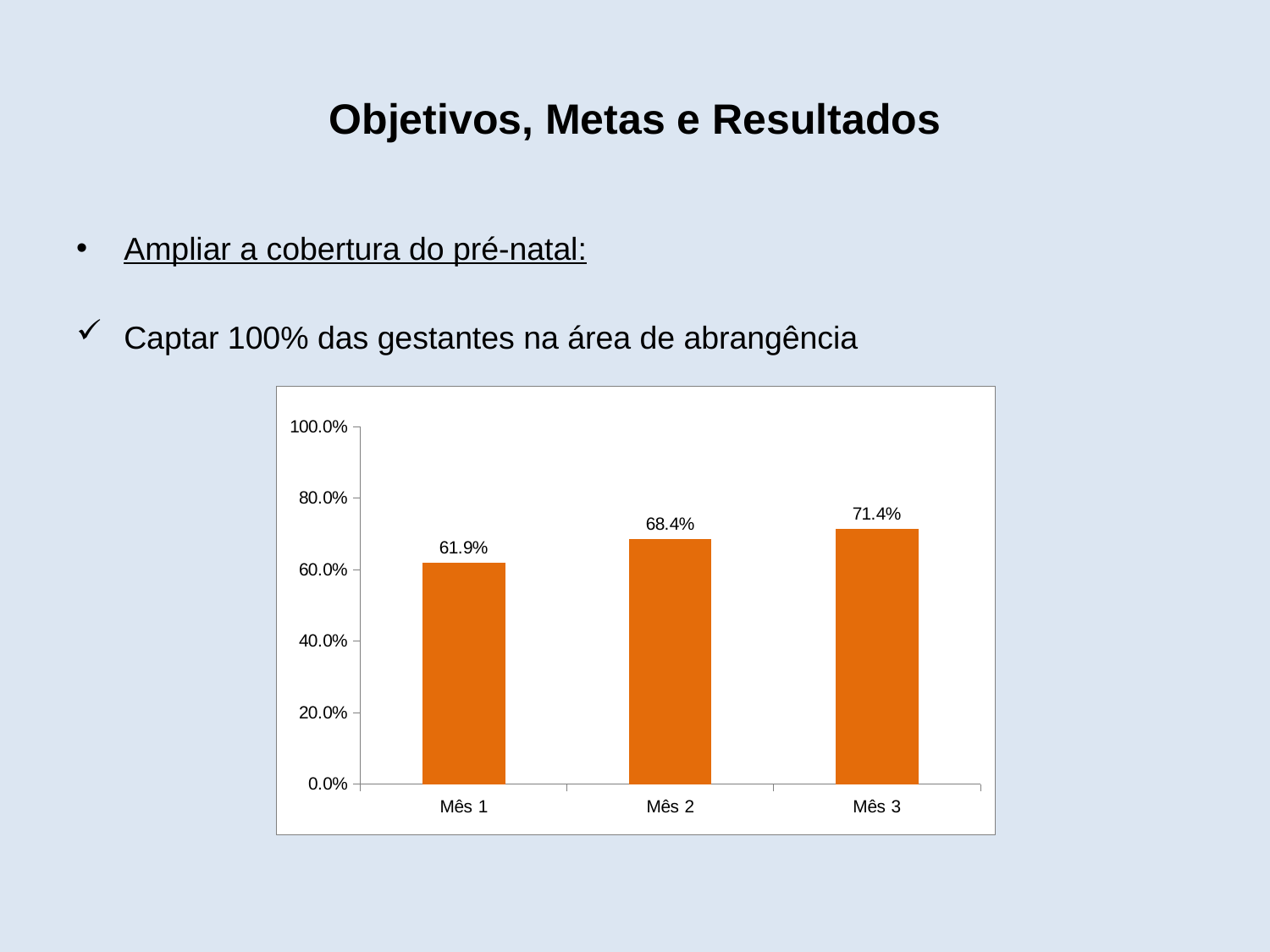
Which month has the lowest value? Mês 1 What is the value for Mês 3? 71.4% What is the value for Mês 1? 61.9% What is the difference between the values for Mês 3 and Mês 1? 9.5% Do the values rise or fall from Mês 1 to Mês 3? rise Is the value for Mês 1 greater or less than 80.0%? less What kind of chart is shown on the slide? bar chart What is the value for Mês 2? 68.4% What is the difference between the values for Mês 2 and Mês 1? 6.5% Which month has the highest value? Mês 3 How many categories are shown on the x axis? 3 Which is larger, the value for Mês 2 or the value for Mês 3? Mês 3